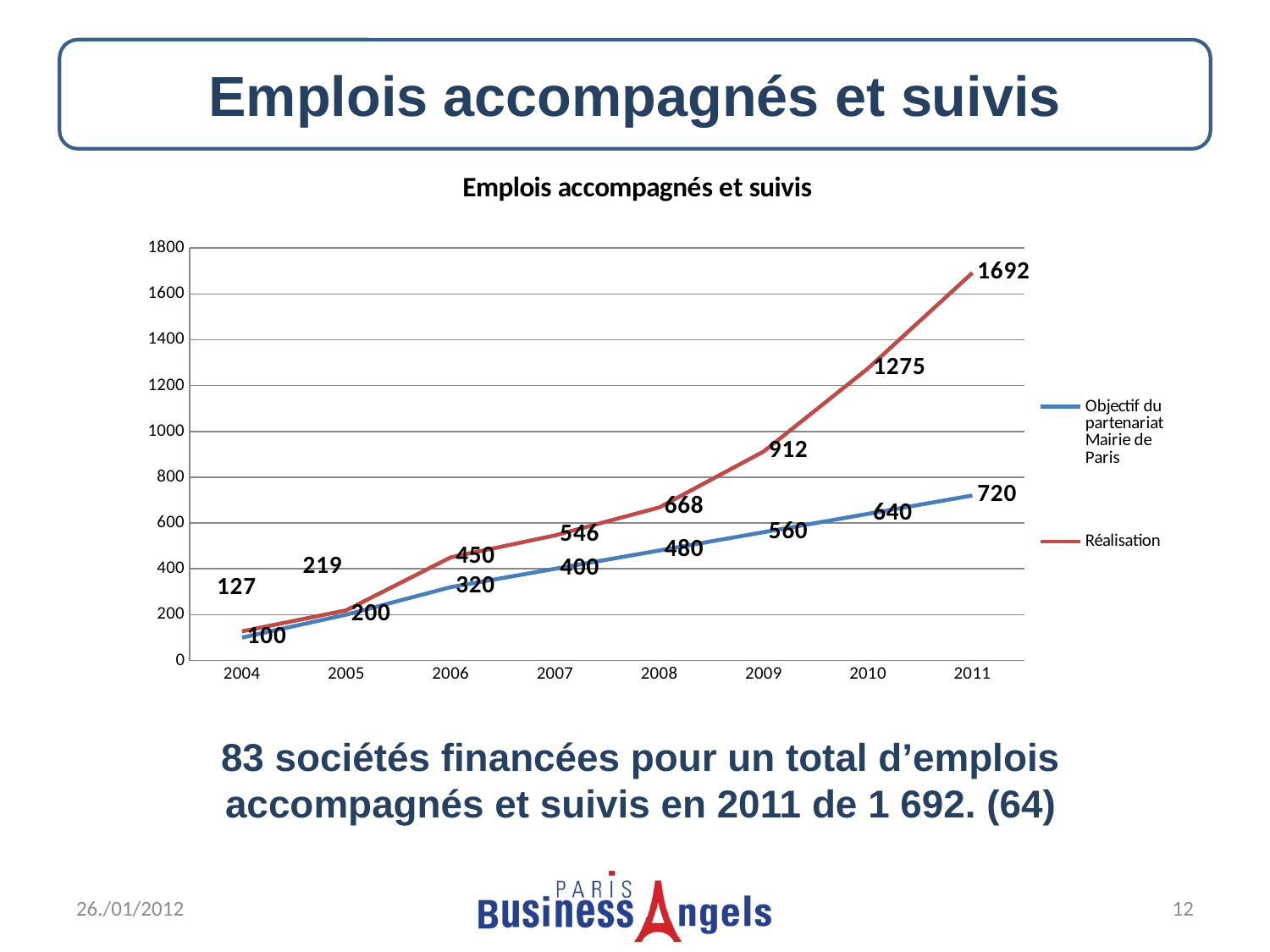
What kind of chart is shown on the slide? line chart In which year is the Objectif du partenariat Mairie de Paris value lowest? 2004 How many years are shown on the x axis? 8 What is the Réalisation value for 2011? 1692 Does the Réalisation series rise or fall from 2004 to 2011? rise What is the difference between the Réalisation and the Objectif du partenariat Mairie de Paris values in 2010? 635 In which year is the Réalisation value highest? 2011 Which is larger in 2009: the Réalisation value or the Objectif du partenariat Mairie de Paris value? Réalisation Is the Réalisation value for 2010 greater or less than 1200? greater What is the Réalisation value for 2006? 450 How many series does the legend list? 2 What is the Objectif du partenariat Mairie de Paris value for 2008? 480